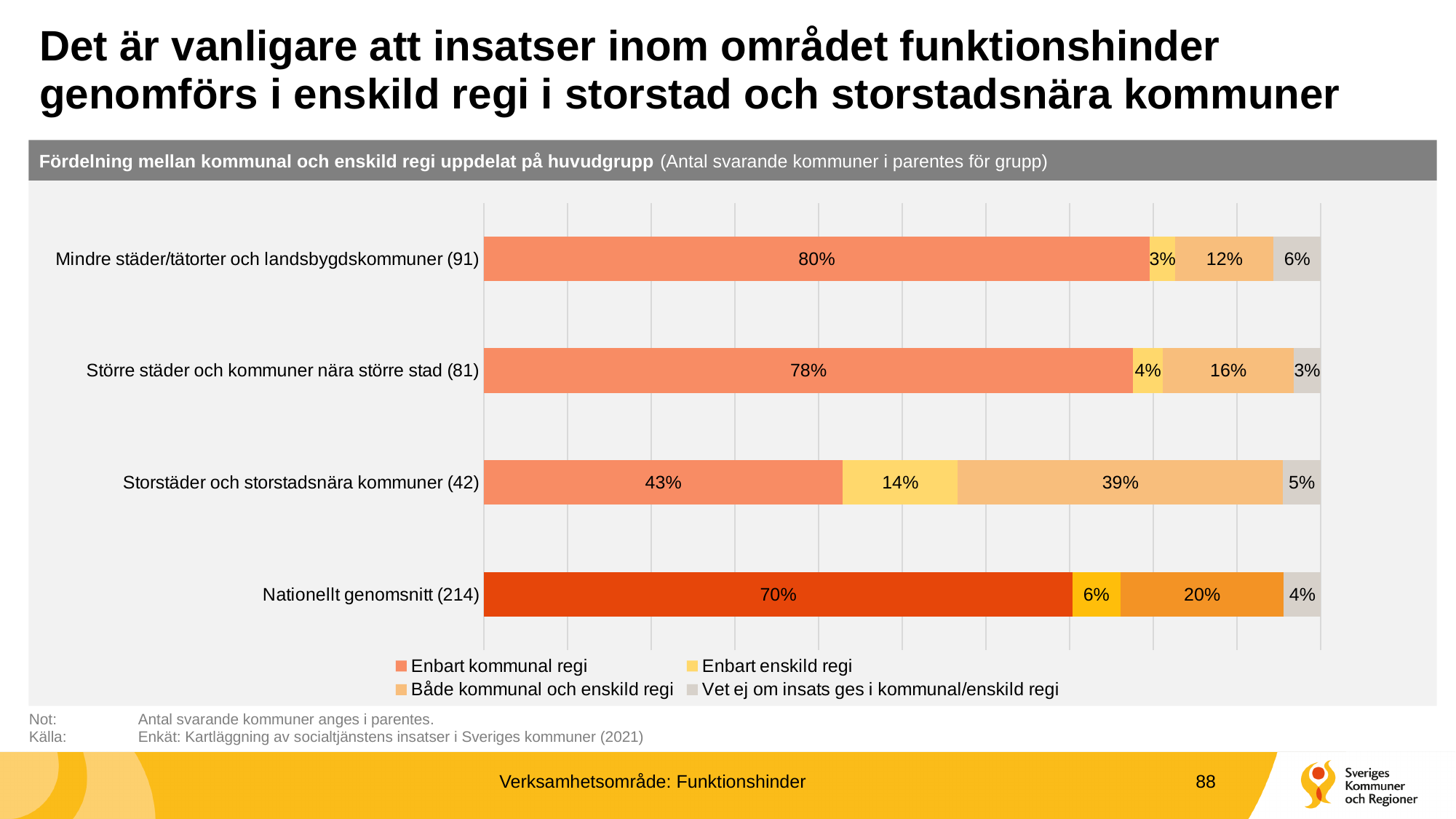
What is the value for 'Enbart kommunal regi' for Storstäder och storstadsnära kommuner (42)? 43% Which category has the highest value for 'Enbart kommunal regi'? Mindre städer/tätorter och landsbygdskommuner (91) What is the value for 'Både kommunal och enskild regi' for Större städer och kommuner nära större stad (81)? 16% How many categories (bars) are shown in the chart? 4 What is the value for 'Vet ej om insats ges i kommunal/enskild regi' for Mindre städer/tätorter och landsbygdskommuner (91)? 6% How many series does the legend list? 4 Which category has the lowest value for 'Både kommunal och enskild regi'? Mindre städer/tätorter och landsbygdskommuner (91) What is the difference in 'Enbart kommunal regi' between Mindre städer/tätorter och landsbygdskommuner (91) and Storstäder och storstadsnära kommuner (42)? 37 percentage points What is the total of the stacked bar for Nationellt genomsnitt (214)? 100% What is the value for 'Enbart enskild regi' for Nationellt genomsnitt (214)? 6% What type of chart is shown on the slide? Stacked bar chart Which is larger: 'Enbart enskild regi' for Storstäder och storstadsnära kommuner (42) or for Större städer och kommuner nära större stad (81)? Storstäder och storstadsnära kommuner (42)